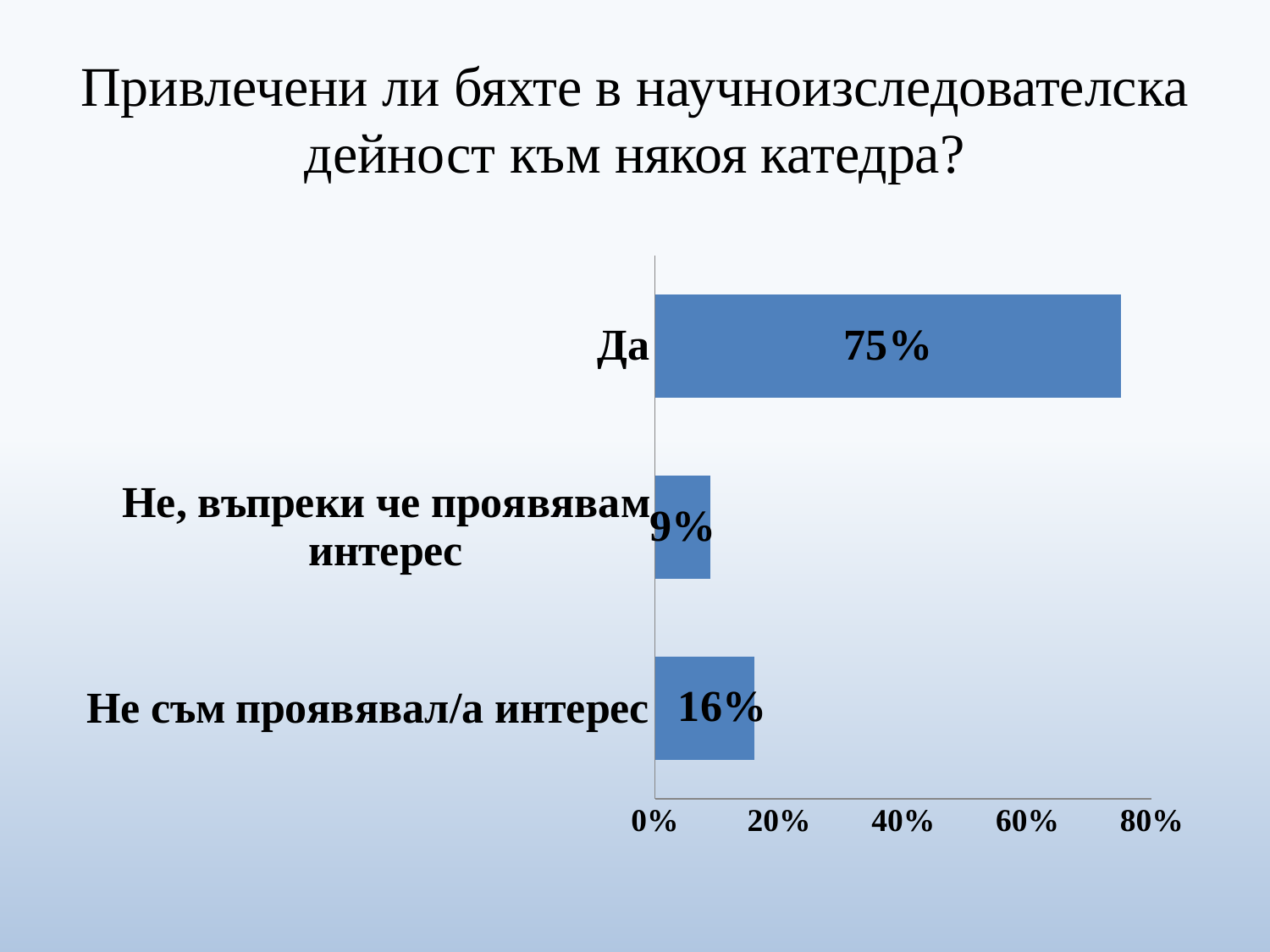
Which category has the lowest value? Не, въпреки че проявявам интерес What is the title of the slide above the chart? Привлечени ли бяхте в научноизследователска дейност към някоя катедра? What is the value for "Не съм проявявал/а интерес"? 16% Which is larger, the value for "Не съм проявявал/а интерес" or the value for "Не, въпреки че проявявам интерес"? Не съм проявявал/а интерес What kind of chart is shown on the slide? bar chart Is the value for "Да" greater or less than 60%? greater Which category has the highest value? Да What is the value for "Да"? 75% What is the value for "Не, въпреки че проявявам интерес"? 9% What is the difference between the values for "Да" and "Не съм проявявал/а интерес"? 59% How many categories are shown in the chart? 3 What is the difference between the values for "Не съм проявявал/а интерес" and "Не, въпреки че проявявам интерес"? 7%